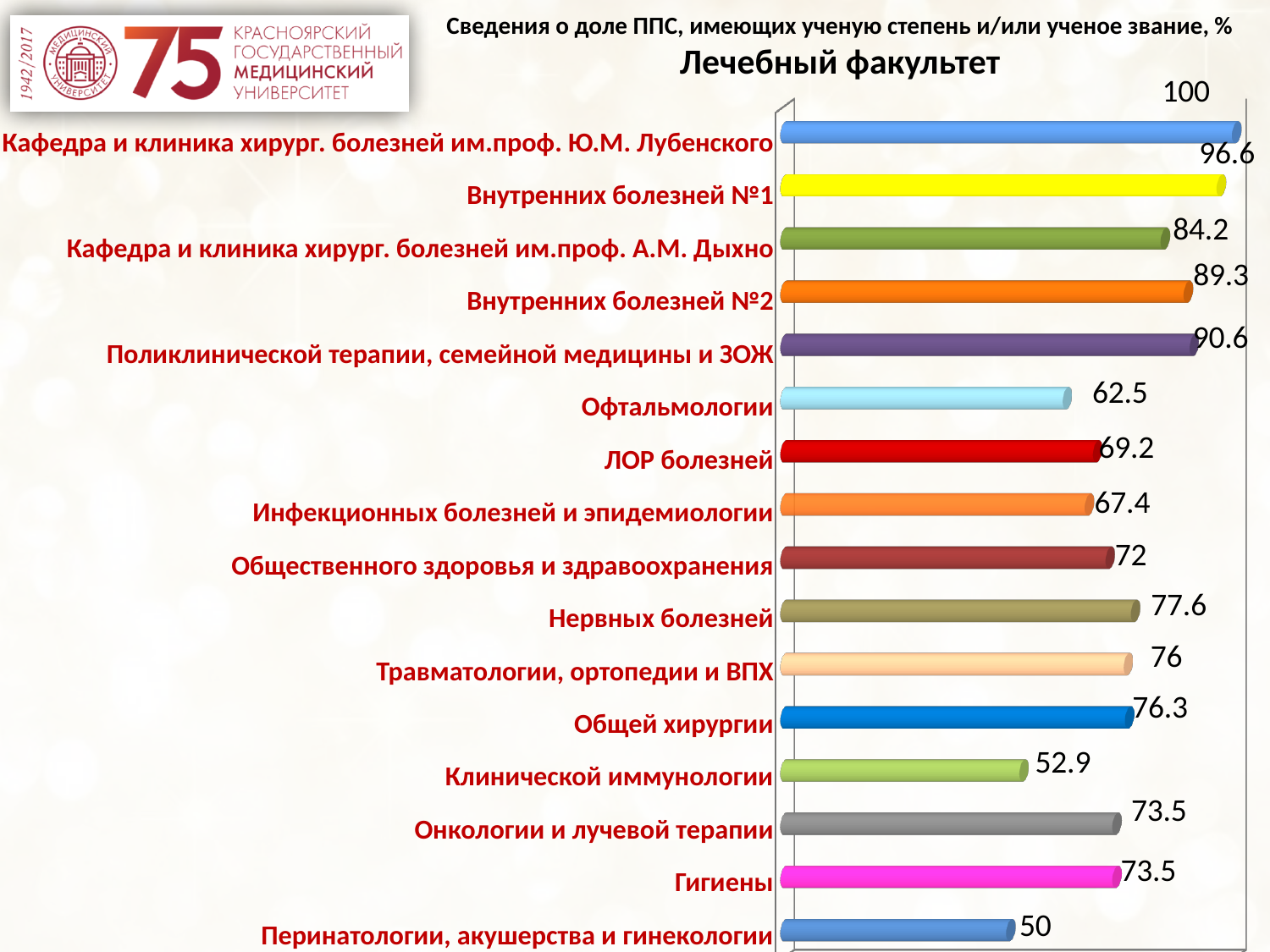
Which category has the lowest value? Перинатологии, акушерства и гинекологии What is the value for Клинической иммунологии? 52.9 What is the difference between the values for Общественного здоровья и здравоохранения and Перинатологии, акушерства и гинекологии? 22 What type of chart is shown on the slide? bar chart What is the value for Офтальмологии? 62.5 What is the title of the chart? Сведения о доле ППС, имеющих ученую степень и/или ученое звание, % Лечебный факультет What is the difference between the values for Внутренних болезней №1 and Внутренних болезней №2? 7.3 What is the value for Нервных болезней? 77.6 Which category has the highest value? Кафедра и клиника хирург. болезней им.проф. Ю.М. Лубенского What is the value for Внутренних болезней №2? 89.3 Which is larger, the value for ЛОР болезней or the value for Инфекционных болезней и эпидемиологии? ЛОР болезней How many categories are shown in the chart? 16